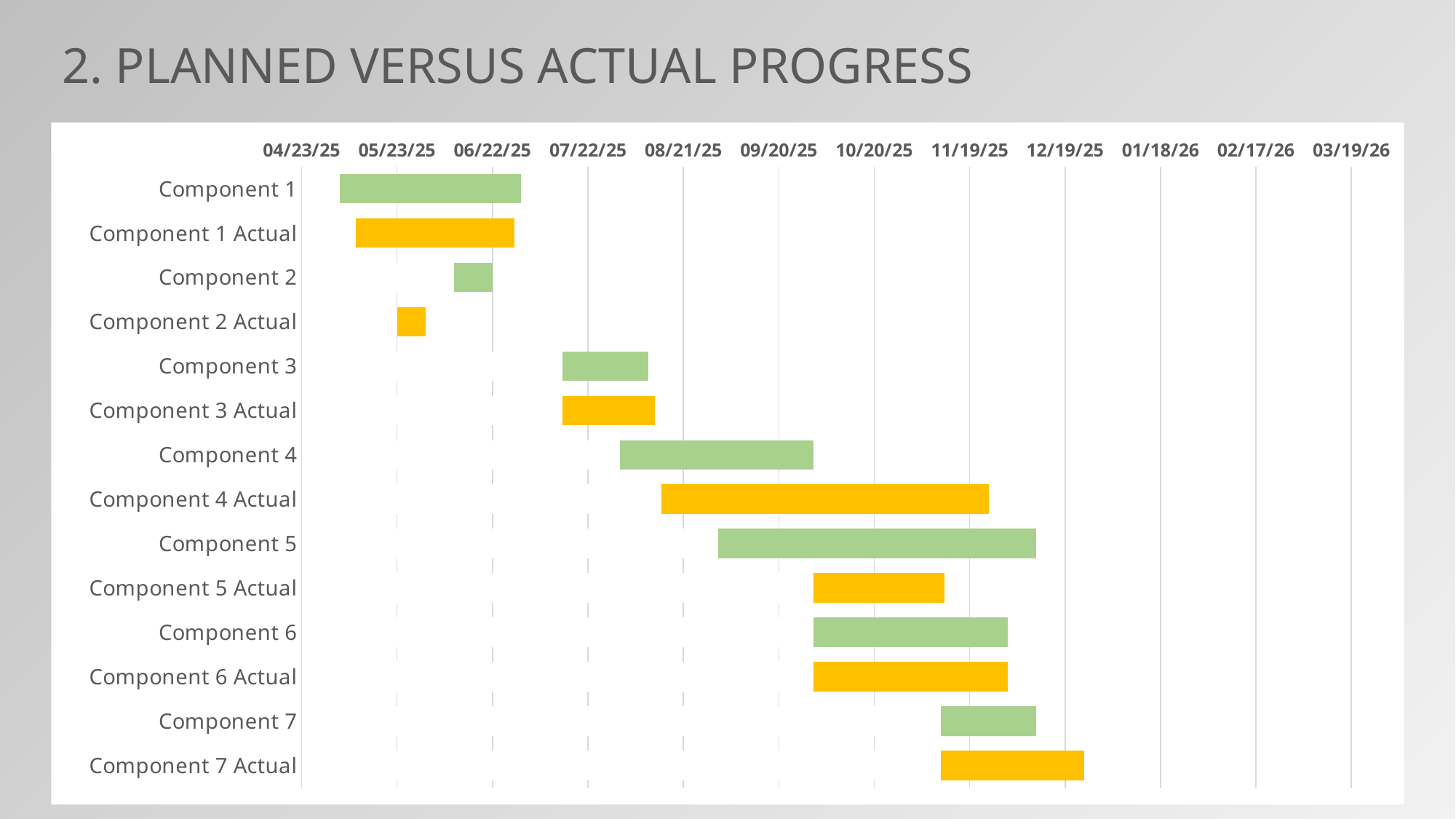
What is the title of the slide containing the chart? 2. PLANNED VERSUS ACTUAL PROGRESS How many components have both a planned and an actual bar on the chart? 7 Does the Component 7 Actual bar end before or after 12/19/25? after Which bar is longer, Component 5 or Component 5 Actual? Component 5 What kind of chart is shown on the slide? Bar chart (Gantt chart) Does the Component 2 Actual bar end before or after 06/22/25? before Which row has the shortest bar on the chart? Component 2 Actual Which bar is longer, Component 4 or Component 4 Actual? Component 4 Actual Which row's bar starts earliest on the timeline? Component 1 What colour are the 'Actual' bars on the chart? Yellow/orange Which row's bar ends latest on the timeline? Component 7 Actual How many rows (categories) are plotted on the chart? 14